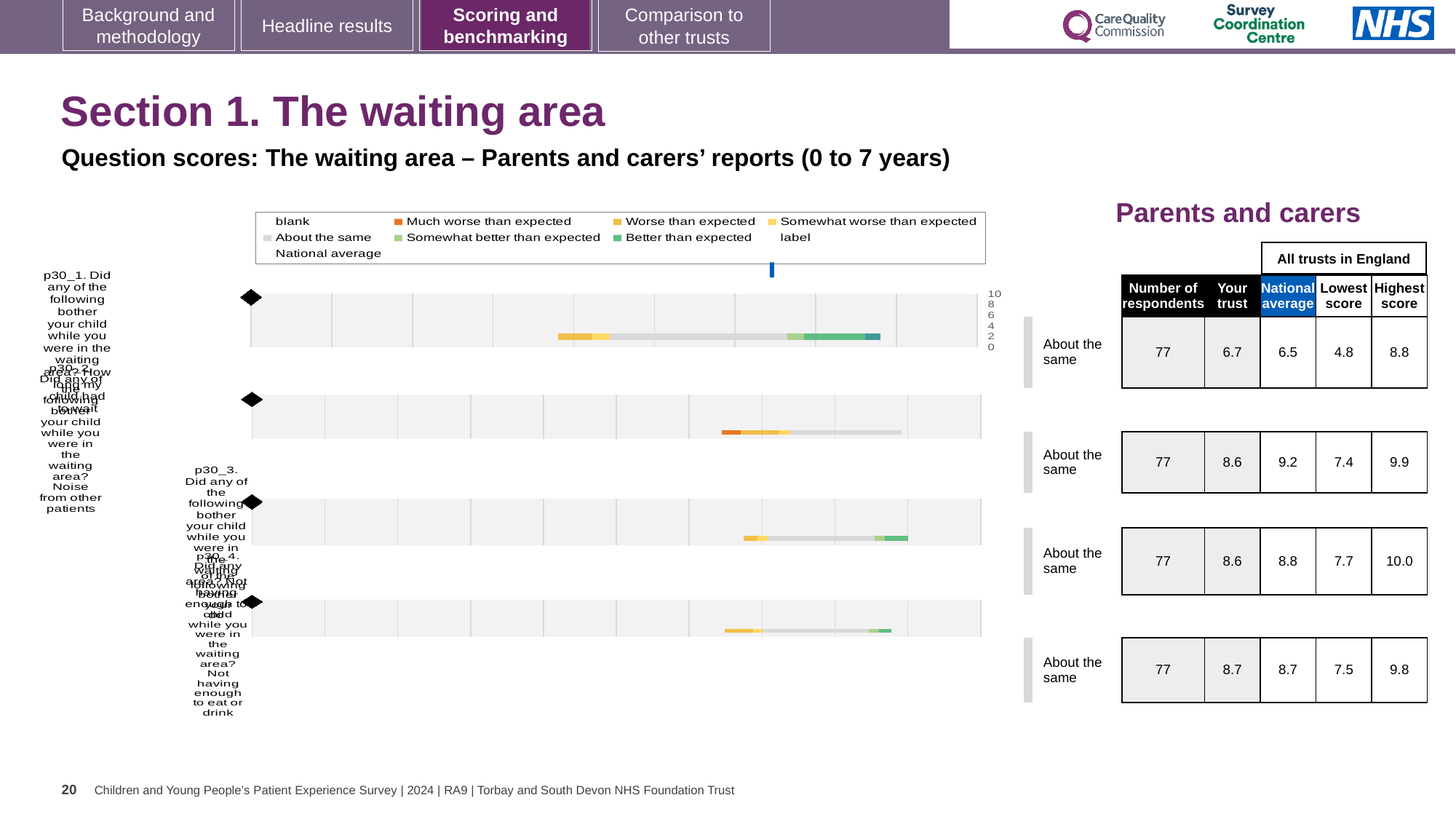
What kind of chart is shown on the slide? bar chart Which legend entry is shown in light grey? About the same How many entries does the chart legend list? 9 In the table beside the chart, which row has the lowest 'Your trust' score? p30_1 (first row) How many bars (question rows) are plotted in the chart? 4 In the table beside the chart, how many respondents are listed for each question row? 77 In the table beside the chart, what is the difference between the highest and lowest score for the first row (p30_1)? 4.0 In the table beside the chart, what is the national average for the second row (p30_2)? 9.2 In the table beside the chart, what is the lowest score for the fourth row (p30_4)? 7.5 Which legend entry is shown in orange? Much worse than expected In the table beside the chart, what is the 'Your trust' score for the first row (p30_1)? 6.7 In the table beside the chart, what is the highest score for the third row (p30_3)? 10.0